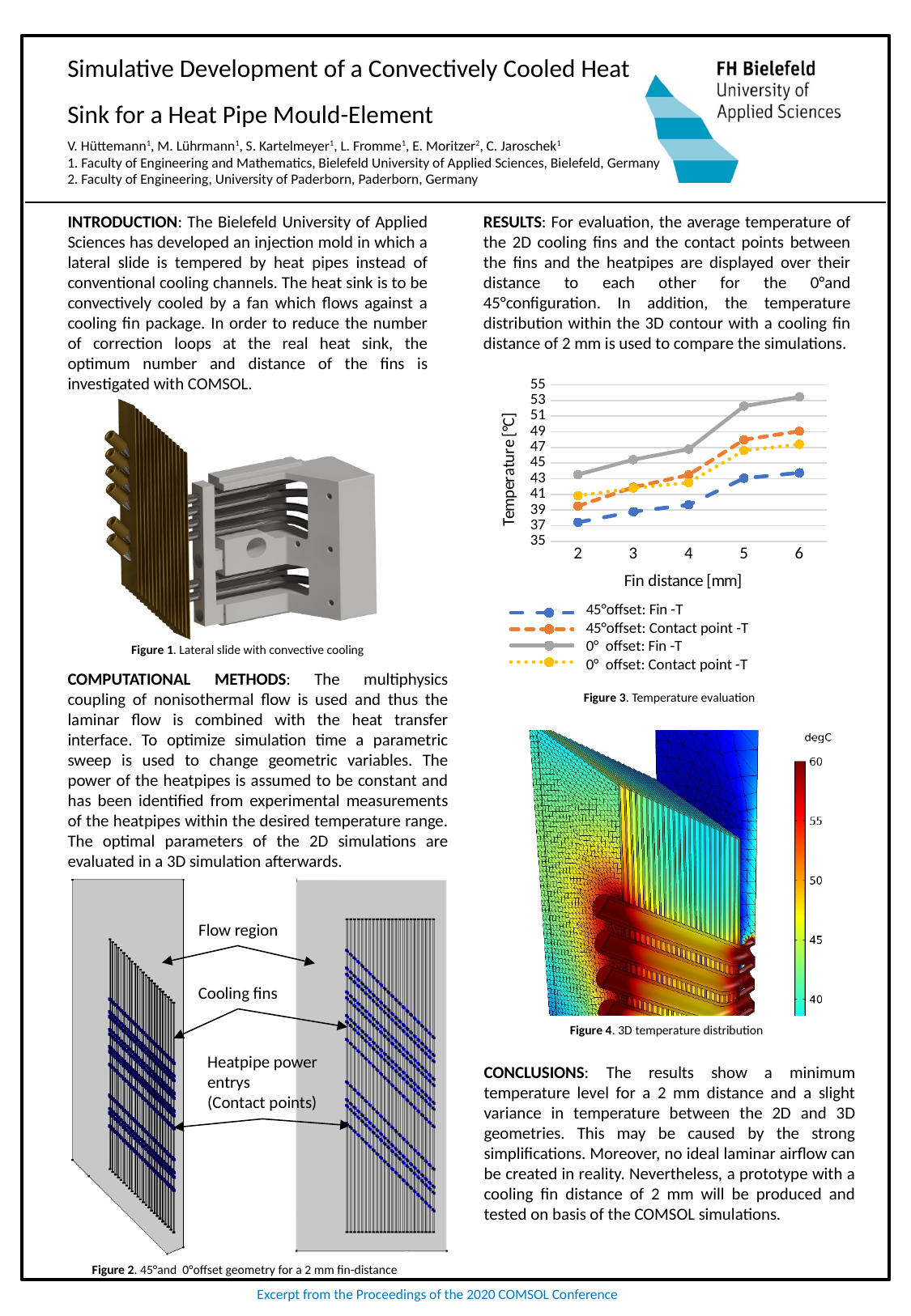
In Figure 3, do the temperatures rise or fall as fin distance increases from 2 mm to 6 mm? rise In Figure 3, which series has the lowest temperature at a fin distance of 2 mm? 45°offset: Fin -T What is the x-axis title of Figure 3? Fin distance [mm] In Figure 3, at which fin distance is the temperature of the 0° offset: Fin -T series lowest? 2 What kind of chart is Figure 3 (Temperature evaluation)? line chart In Figure 3, is the temperature of the 45°offset: Contact point -T series at 6 mm greater or less than 47? greater In Figure 3, is the temperature of the 45°offset: Fin -T series at 2 mm greater or less than 39? less In Figure 3, is the temperature of the 0° offset: Fin -T series at 6 mm greater or less than 51? greater In Figure 3, which series has the highest temperature at a fin distance of 6 mm? 0° offset: Fin -T In Figure 3, at a fin distance of 4 mm, which is higher: the 0° offset: Fin -T series or the 45°offset: Fin -T series? 0° offset: Fin -T How many series does the legend of Figure 3 list? 4 How many fin distance values are plotted along the x axis of Figure 3? 5